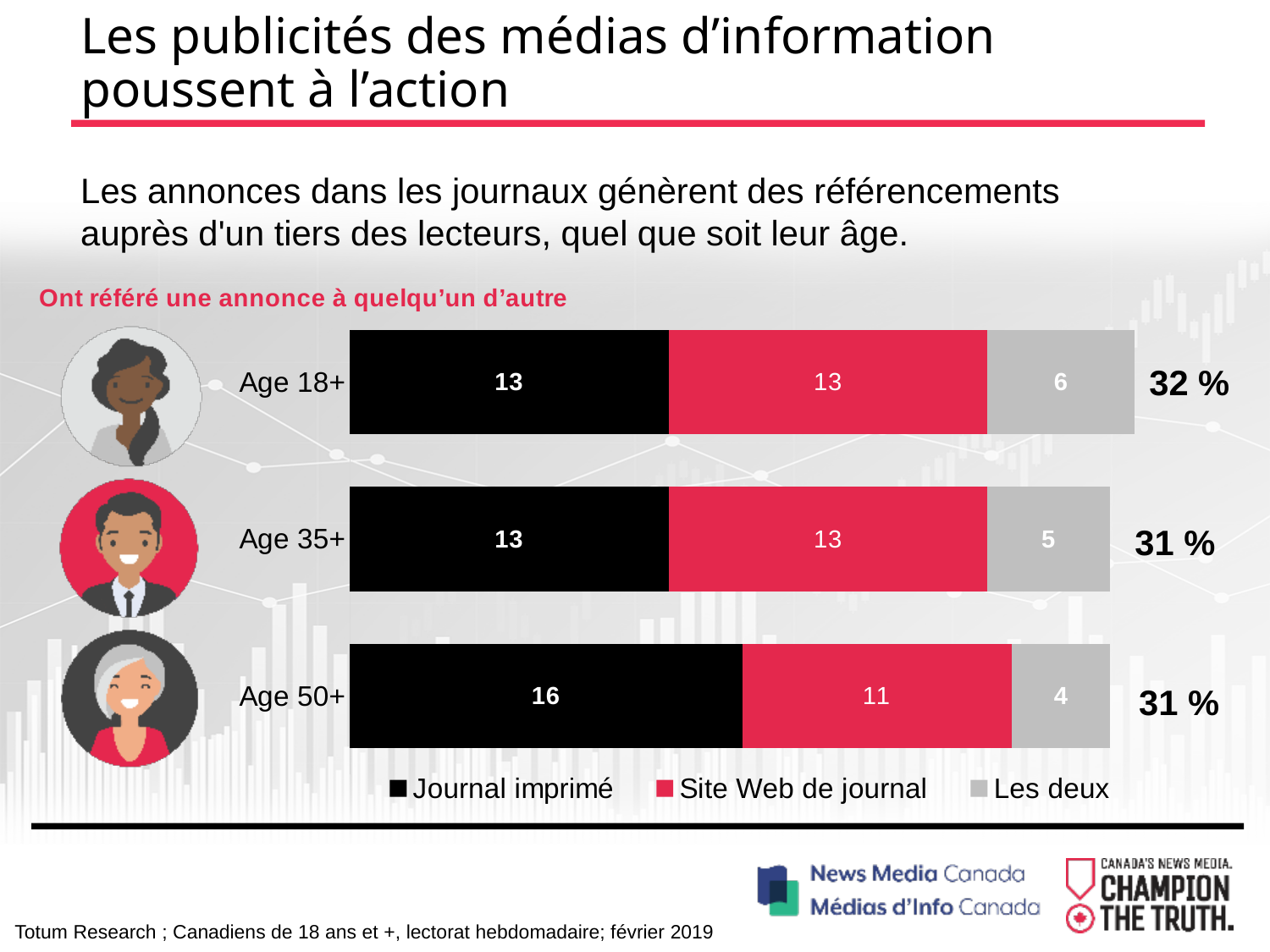
Which colour represents Site Web de journal in the chart? Red How many age categories are plotted in the chart? 3 What is the value for Les deux for Age 35+? 5 What is the value for Site Web de journal for Age 18+? 13 What is the value for Journal imprimé for Age 50+? 16 Which age group has the highest value for Journal imprimé? Age 50+ What is the total shown for the Age 18+ bar? 32 % What type of chart is shown on the slide? Stacked bar chart Which is larger for Age 50+: Journal imprimé or Site Web de journal? Journal imprimé How many series does the chart legend list? 3 Which age group has the lowest value for Les deux? Age 50+ What is the difference between the Journal imprimé value for Age 50+ and for Age 18+? 3